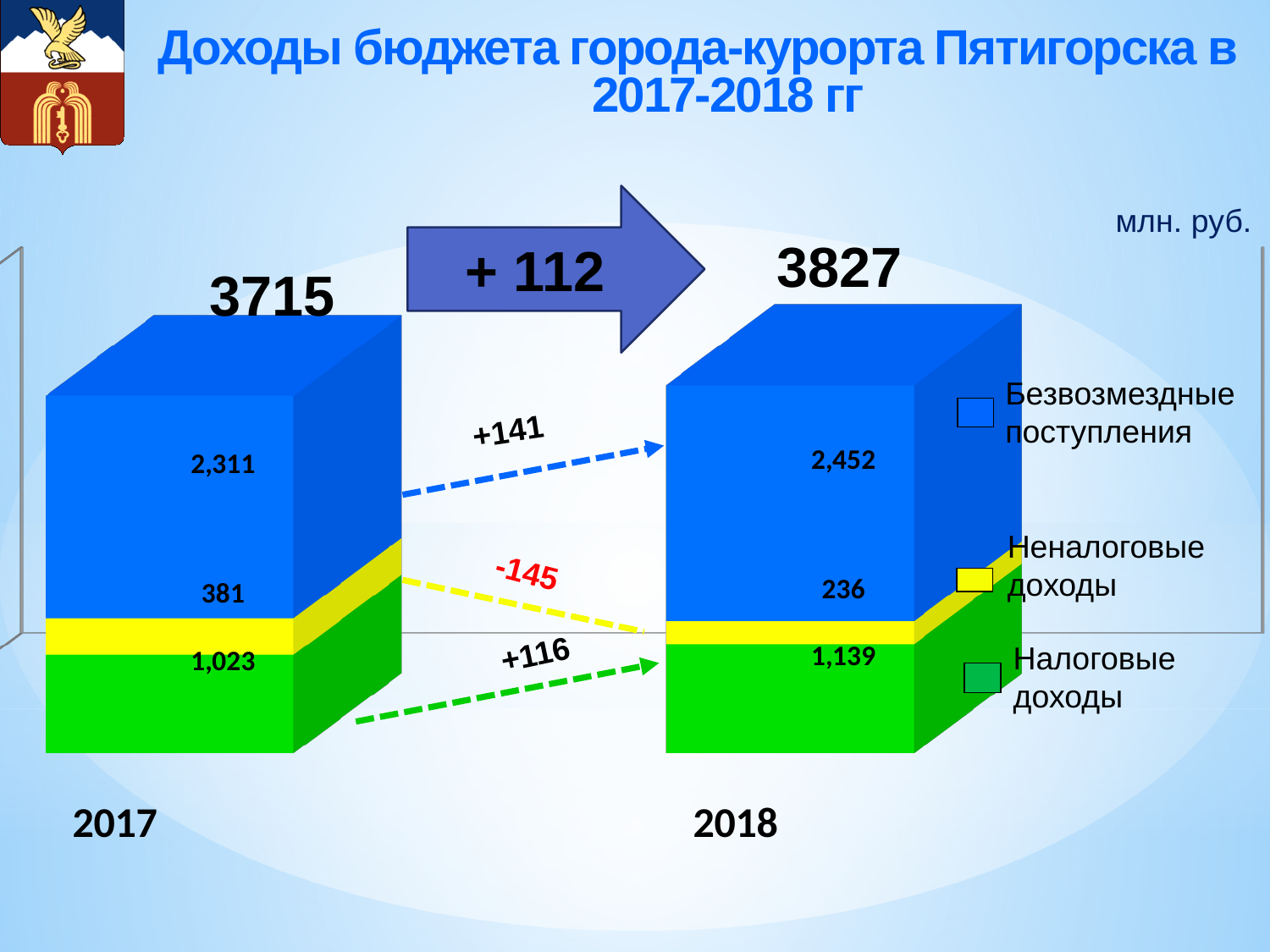
What is the value of Неналоговые доходы for 2017? 381 What is the value of Неналоговые доходы for 2018? 236 Which series has the lowest value in 2018? Неналоговые доходы What is the value of Безвозмездные поступления for 2017? 2,311 What is the value of Налоговые доходы for 2018? 1,139 Which year has the larger value for Налоговые доходы, 2017 or 2018? 2018 What kind of chart is shown on the slide? Stacked bar chart By how much did Безвозмездные поступления change from 2017 to 2018? +141 How many series does the legend list? 3 What is the total of the stacked bar for 2017? 3715 By how much did Неналоговые доходы change from 2017 to 2018? -145 What is the total of the stacked bar for 2018? 3827